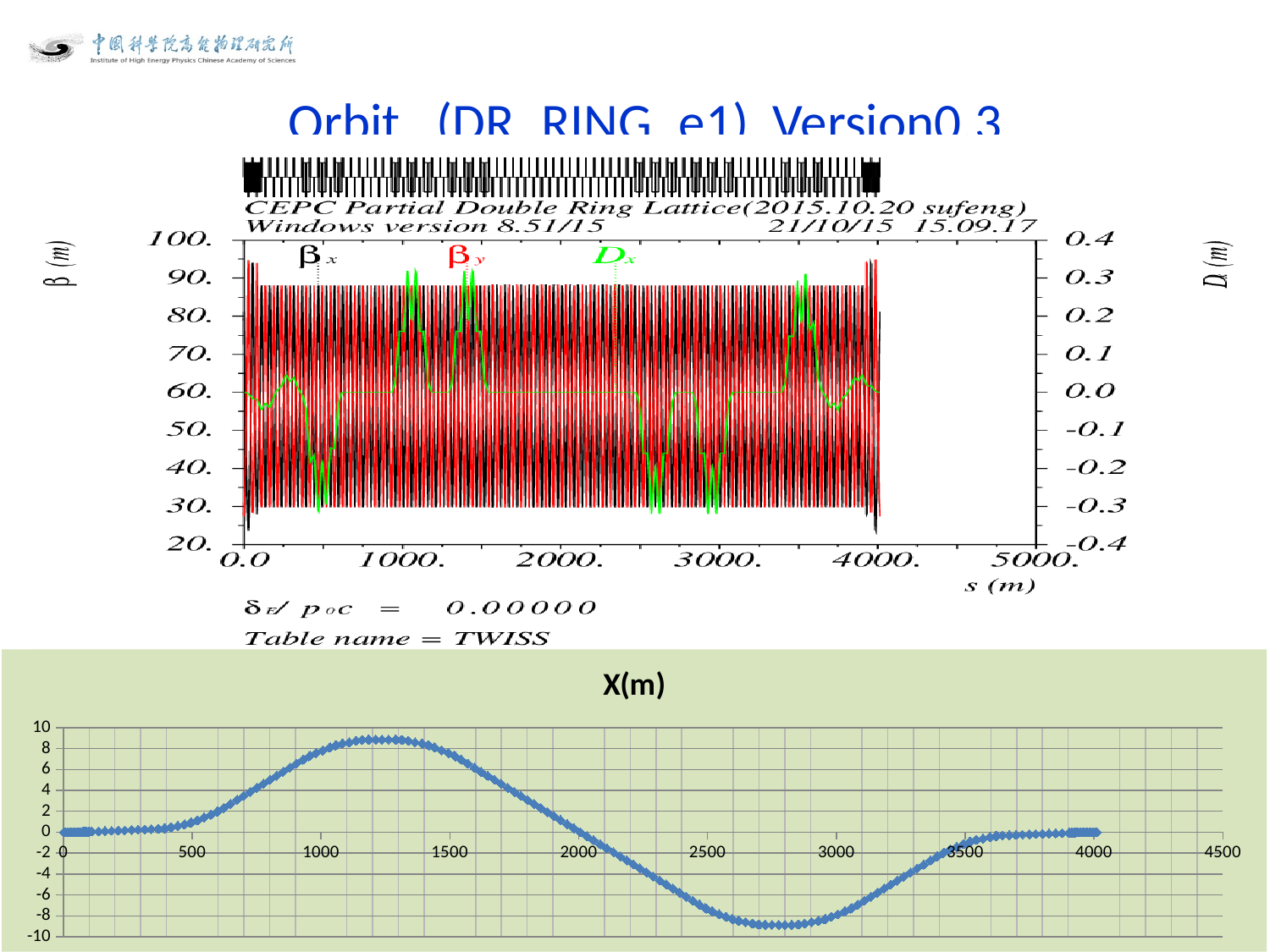
In the bottom chart X(m), is the value at s = 500 greater or less than 5? less In the top chart (CEPC Partial Double Ring Lattice), what colour is the Dx curve? green What is the label of the horizontal axis in the top chart (CEPC Partial Double Ring Lattice)? s (m) What kind of chart is the bottom chart titled X(m)? line chart How many series are labelled in the top chart (CEPC Partial Double Ring Lattice)? 3 In the bottom chart X(m), do the values rise or fall between s = 500 and s = 1200? rise In the bottom chart X(m), is the value at s = 1200 greater or less than 5? greater What is the highest tick shown on the vertical axis of the bottom chart X(m)? 10 In the bottom chart X(m), do the values rise or fall between s = 1200 and s = 2700? fall In the bottom chart X(m), which is larger, the value at s = 1200 or the value at s = 2700? the value at s = 1200 In the bottom chart X(m), is the value at s = 2700 greater or less than -5? less